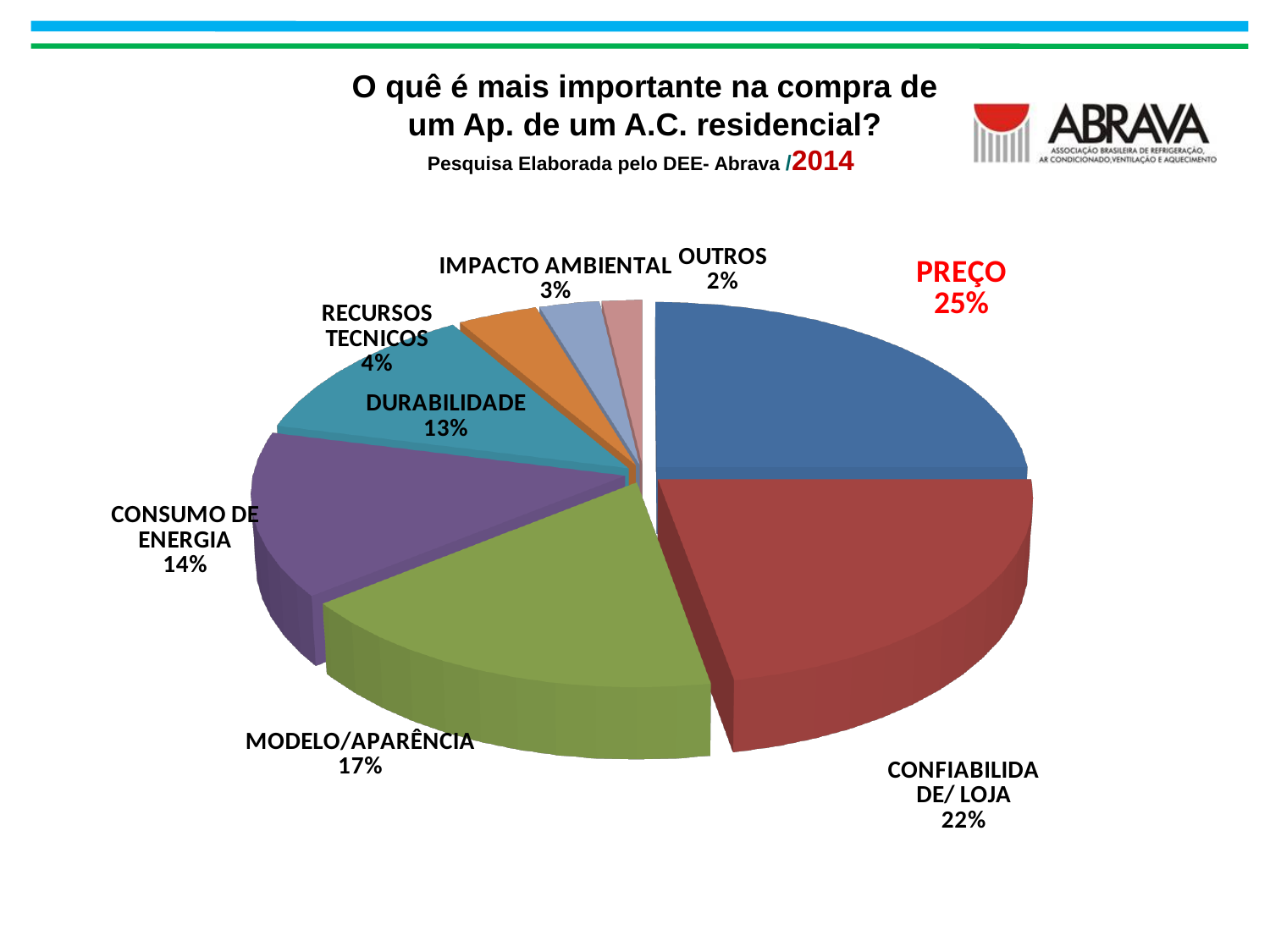
Which is larger, the value for RECURSOS TECNICOS or the value for IMPACTO AMBIENTAL? RECURSOS TECNICOS Which category's label is printed in red on the chart? PREÇO What kind of chart is shown on the slide? Pie chart What is the value for DURABILIDADE? 13% Which category has the smallest slice of the pie? OUTROS How many categories are shown in the pie chart? 8 What is the value for MODELO/APARÊNCIA? 17% What is the value for CONFIABILIDADE/ LOJA? 22% What is the difference between the values for PREÇO and CONFIABILIDADE/ LOJA? 3% Which category has the largest slice of the pie? PREÇO What is the value for CONSUMO DE ENERGIA? 14% What share of the pie does PREÇO represent? 25%